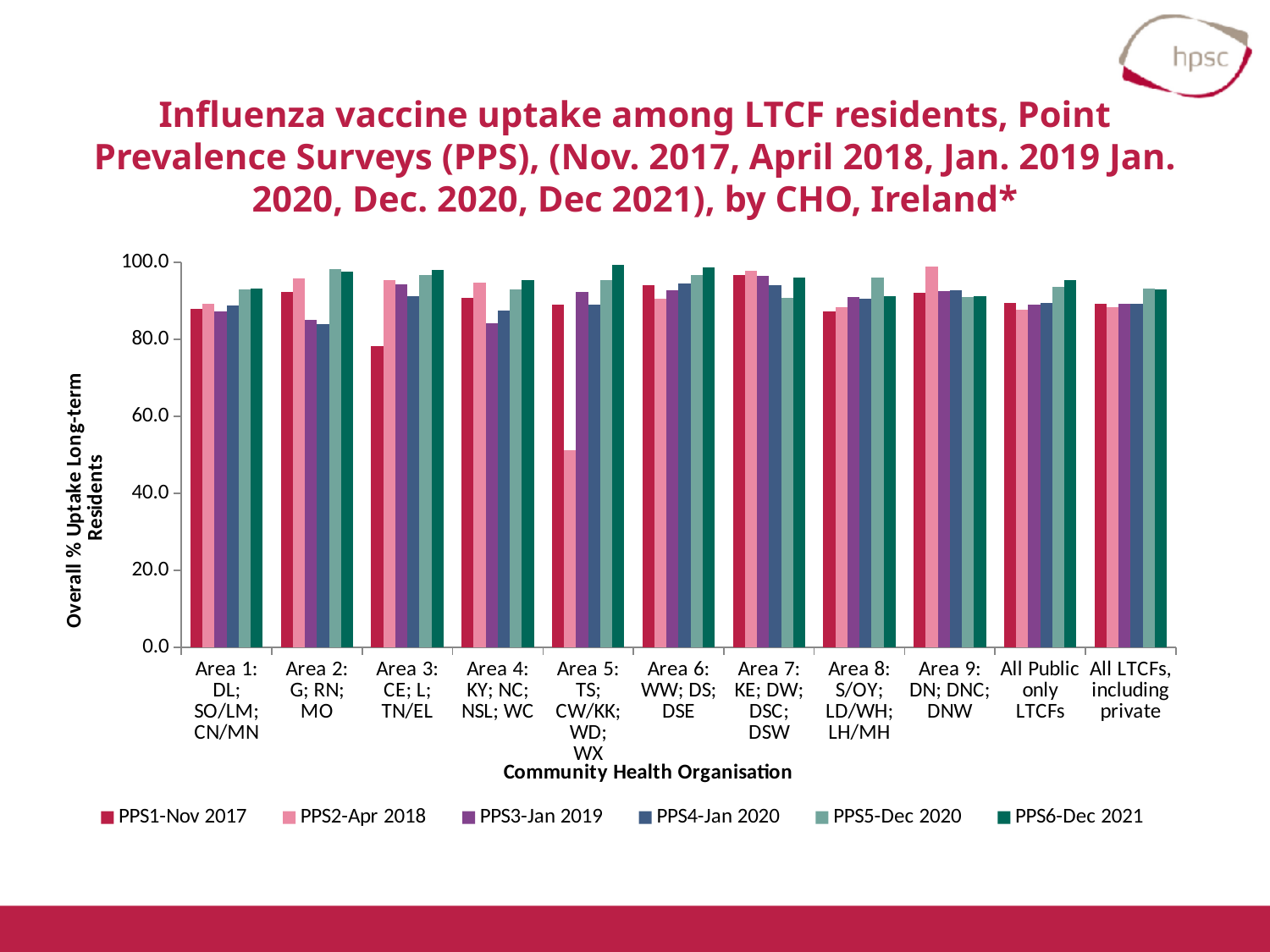
In Area 3, which is larger: the PPS1-Nov 2017 value or the PPS6-Dec 2021 value? PPS6-Dec 2021 Which category has the lowest value for the PPS2-Apr 2018 series? Area 5: TS; CW/KK; WD; WX What is the title of the y axis? Overall % Uptake Long-term Residents Is the value for PPS2-Apr 2018 in Area 5 greater or less than 60.0? less How many series does the legend list? 6 In Area 5, which is larger: the PPS2-Apr 2018 value or the PPS6-Dec 2021 value? PPS6-Dec 2021 Is the value for PPS2-Apr 2018 in Area 9 greater or less than 80.0? greater Is the value for PPS1-Nov 2017 in Area 3 greater or less than 80.0? less What kind of chart is shown on the slide? bar chart Which category has the lowest value for the PPS1-Nov 2017 series? Area 3: CE; L; TN/EL How many categories are shown along the x axis? 11